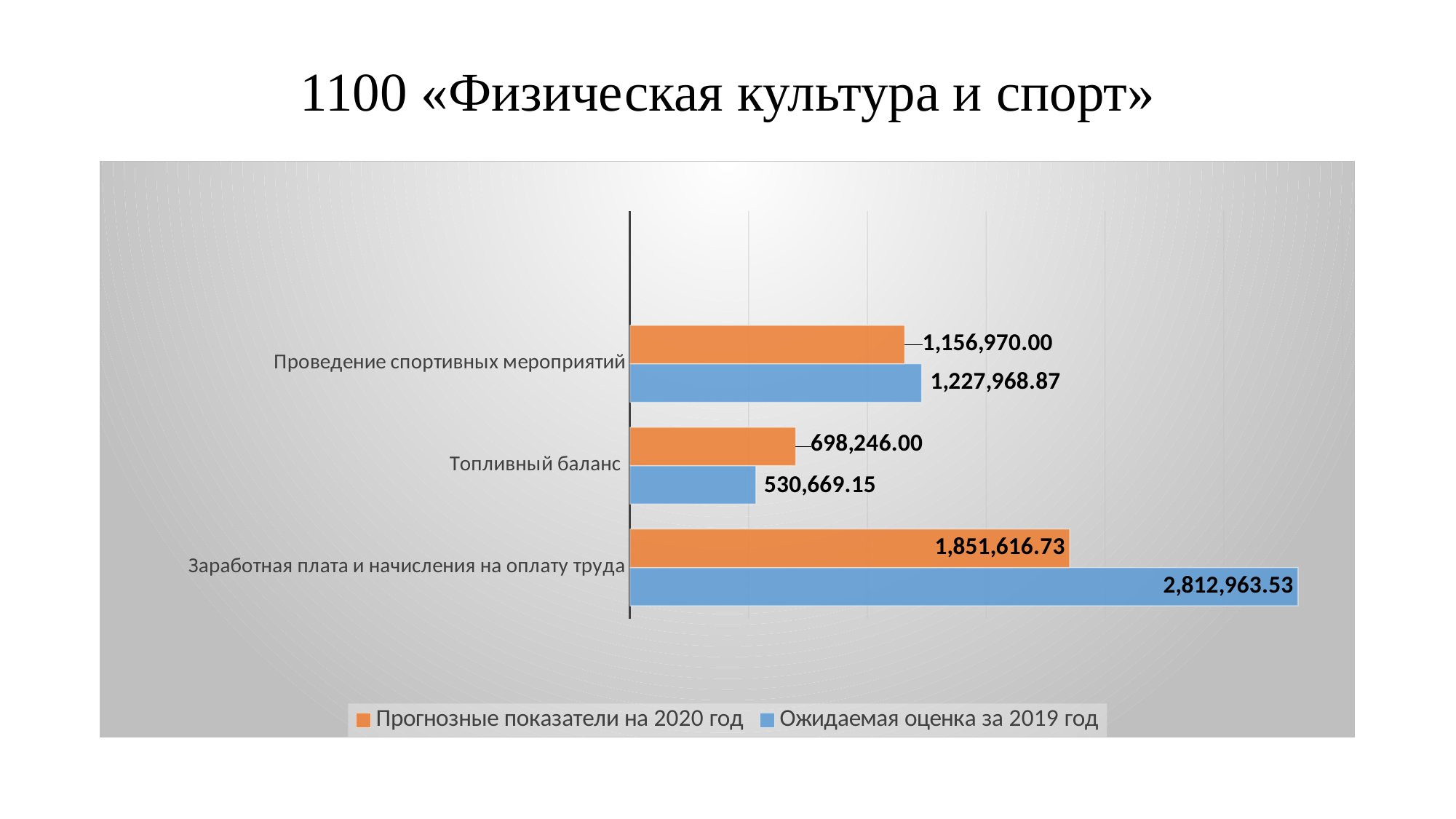
What is the difference between the 2020 and 2019 values for «Топливный баланс»? 167,576.85 What is the value of «Прогнозные показатели на 2020 год» for «Топливный баланс»? 698,246.00 How many series does the legend list? 2 What is the difference between the 2019 and 2020 values for «Заработная плата и начисления на оплату труда»? 961,346.80 For «Проведение спортивных мероприятий», which is larger: the 2020 forecast or the 2019 expected estimate? Ожидаемая оценка за 2019 год How many categories are shown on the chart? 3 Which category has the highest value for «Ожидаемая оценка за 2019 год»? Заработная плата и начисления на оплату труда Which category has the lowest value for «Прогнозные показатели на 2020 год»? Топливный баланс What is the value of «Прогнозные показатели на 2020 год» for «Проведение спортивных мероприятий»? 1,156,970.00 What is the value of «Ожидаемая оценка за 2019 год» for «Топливный баланс»? 530,669.15 What type of chart is shown on the slide? Bar chart What is the value of «Ожидаемая оценка за 2019 год» for «Заработная плата и начисления на оплату труда»? 2,812,963.53